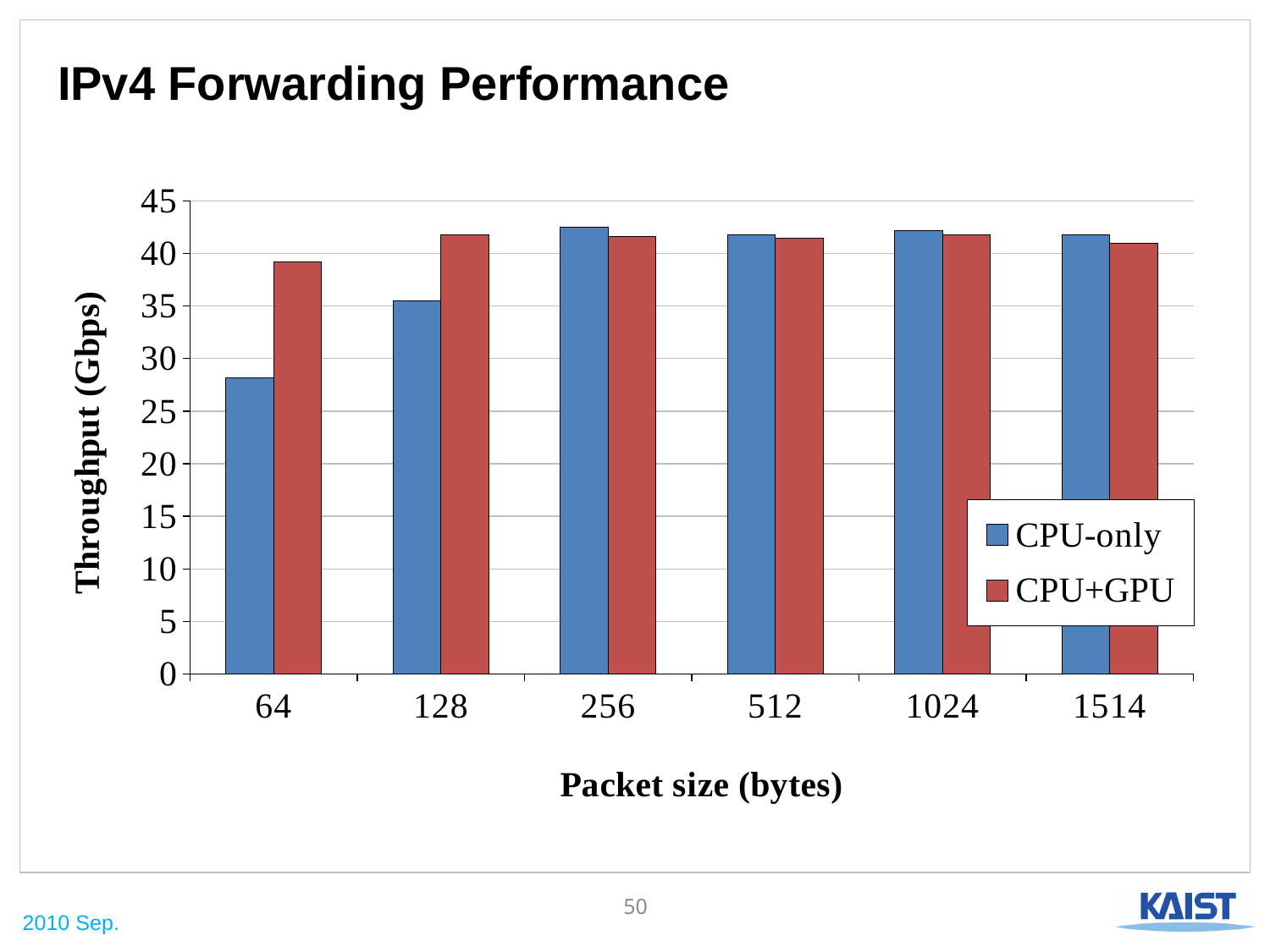
Which packet size has the lowest CPU-only throughput? 64 At a packet size of 128 bytes, which is larger: CPU-only or CPU+GPU throughput? CPU+GPU Is the CPU+GPU throughput at 64 bytes greater or less than 35? greater Which packet size has the lowest CPU+GPU throughput? 64 At a packet size of 64 bytes, which is larger: CPU-only or CPU+GPU throughput? CPU+GPU How many packet sizes are shown on the x axis? 6 How many series does the legend list? 2 Is the CPU-only throughput at 128 bytes greater or less than 40? less Is the CPU-only throughput at 64 bytes greater or less than 30? less Does the CPU-only throughput rise or fall from 64 bytes to 256 bytes? rise What is the label of the y axis? Throughput (Gbps) What kind of chart is shown on the slide? bar chart